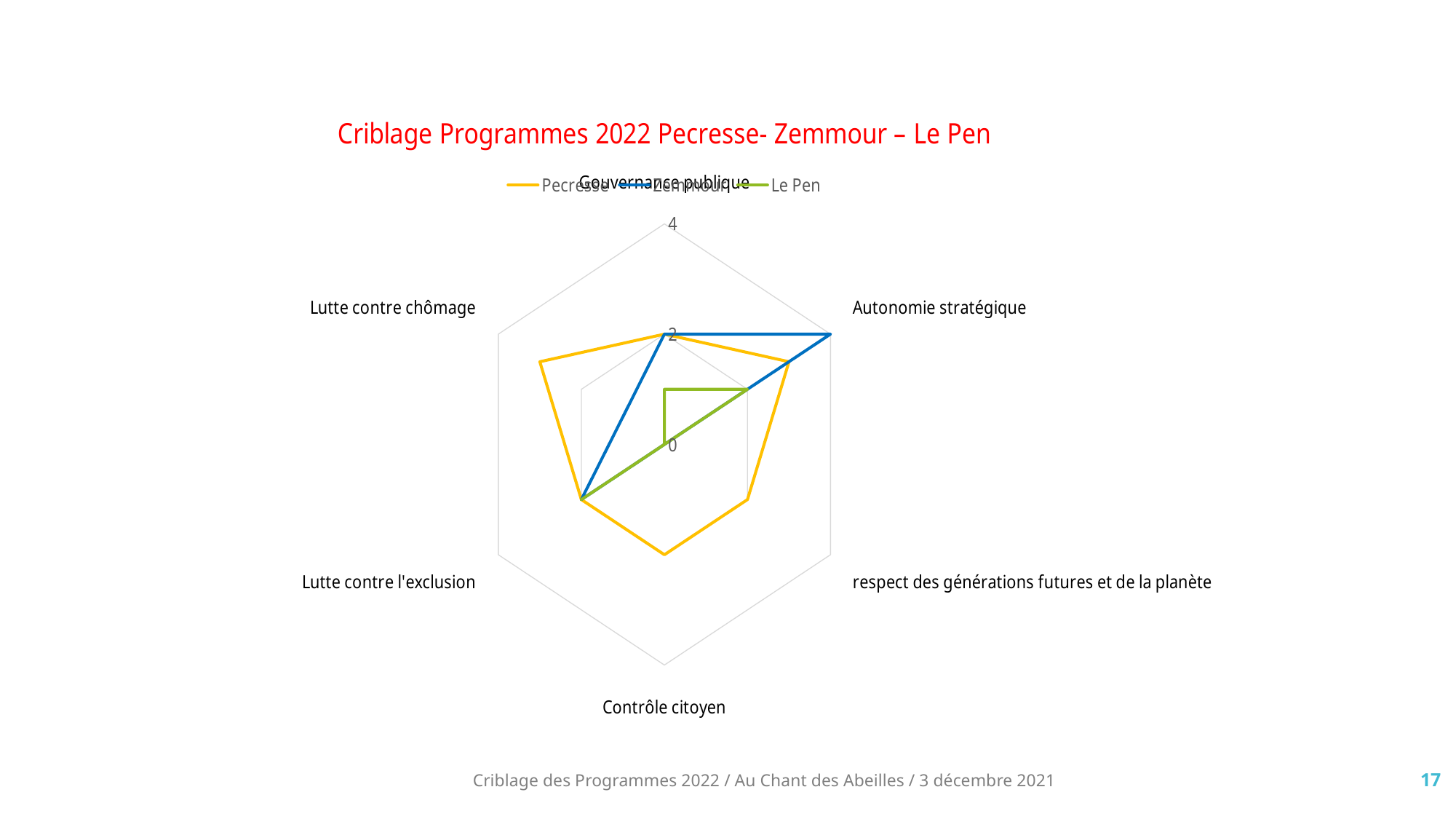
What is the value for Zemmour on Gouvernance publique? 2 Which series is drawn in yellow? Pecresse Which is larger on Autonomie stratégique: Zemmour or Le Pen? Zemmour What is the value for Zemmour on Autonomie stratégique? 4 Is the value for Le Pen on Gouvernance publique greater or less than 2? less What is the value for Pecresse on Gouvernance publique? 2 How many categories (axes) does the radar chart have? 6 Which is larger on Contrôle citoyen: Pecresse or Zemmour? Pecresse On which category does Zemmour reach his highest value? Autonomie stratégique Is the value for Pecresse on Lutte contre chômage greater or less than 2? greater What kind of chart is shown on the slide? Radar chart How many series does the legend list? 3